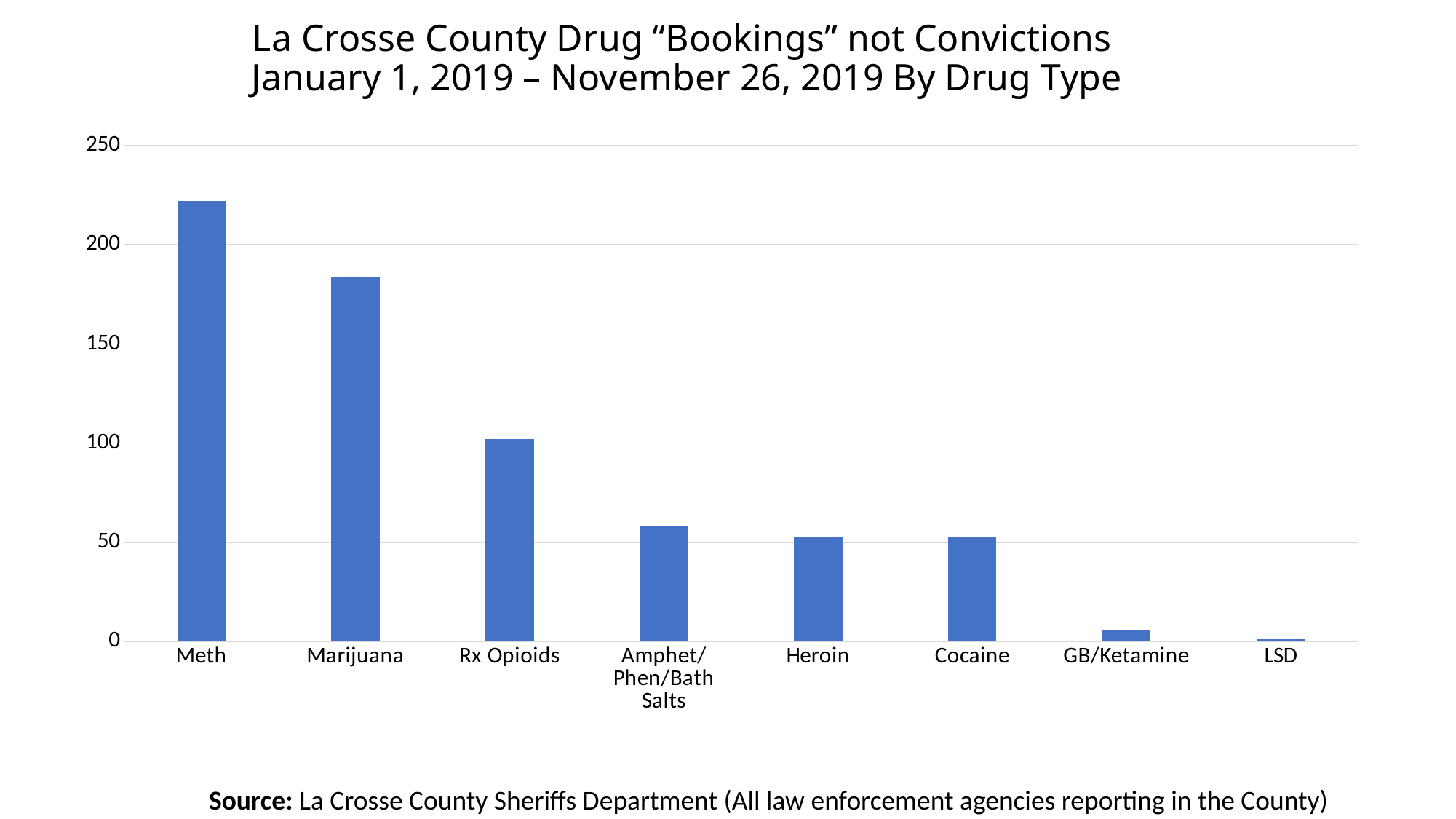
Is the value for Meth greater or less than 200? greater Which drug type has the lowest number of bookings? LSD Is the value for Rx Opioids greater or less than 150? less How many drug types are shown on the x axis? 8 Is the value for Marijuana greater or less than 150? greater Which has more bookings, Marijuana or Rx Opioids? Marijuana Do the bookings generally rise or fall moving from left to right across the drug types? fall Which drug type has the highest number of bookings? Meth What kind of chart is shown on the slide? bar chart What source is cited for the data on the slide? La Crosse County Sheriffs Department